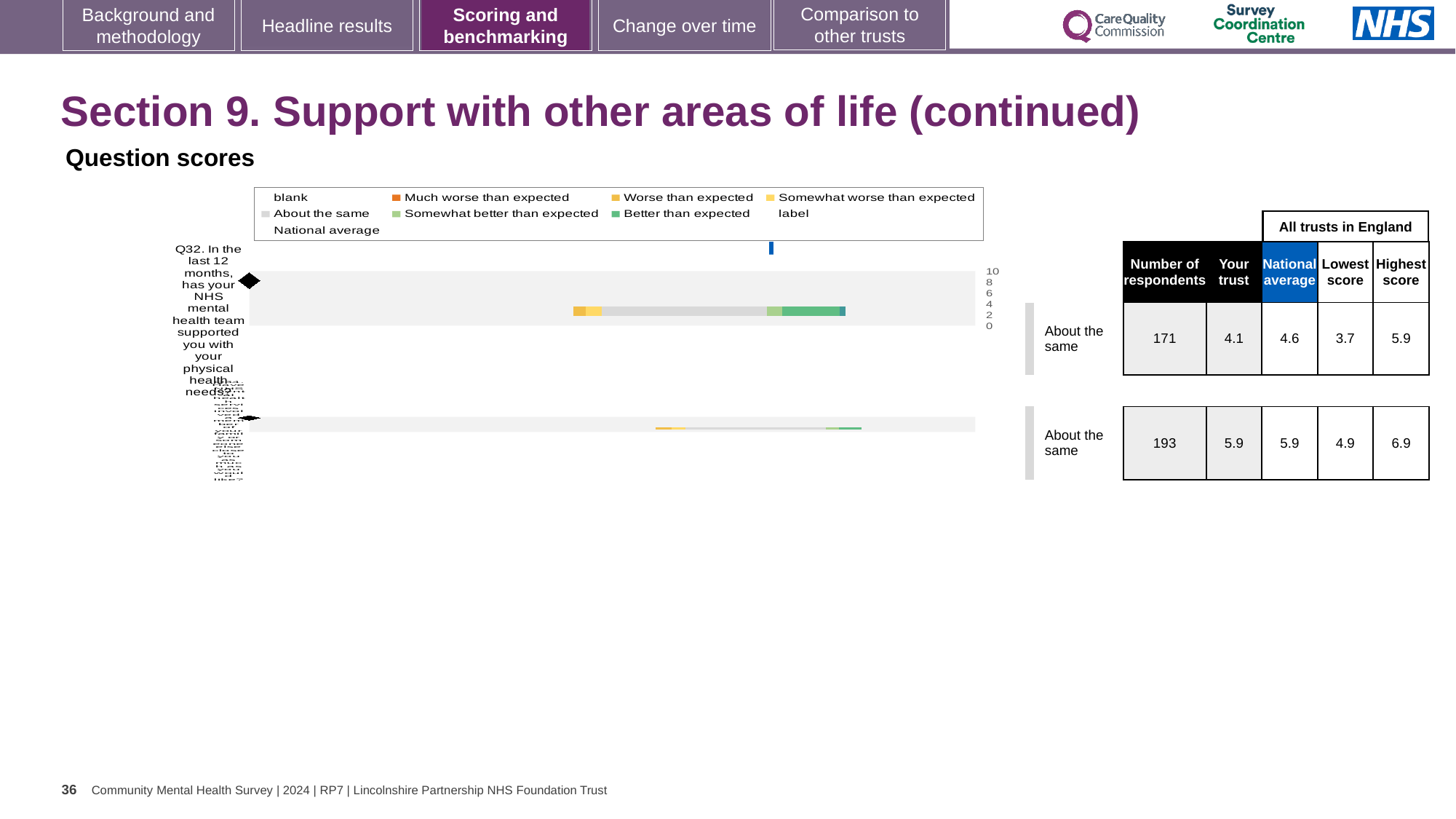
For Q32, which is larger: the trust's score or the national average? National average How many question bars are plotted in the chart? 2 What is the 'Your trust' score for Q32 (support with physical health needs)? 4.1 What is the highest score among all trusts in England for Q32? 5.9 What is the national average score for Q32? 4.6 What kind of chart is shown on the slide? bar chart What is the 'Your trust' score for the second (lower) question bar? 5.9 What is the difference between the highest and lowest trust scores for Q32? 2.2 How many respondents answered Q32? 171 Is the trust's score marker for Q32 greater or less than 6 on the axis? less What is the lowest score among all trusts in England for Q32? 3.7